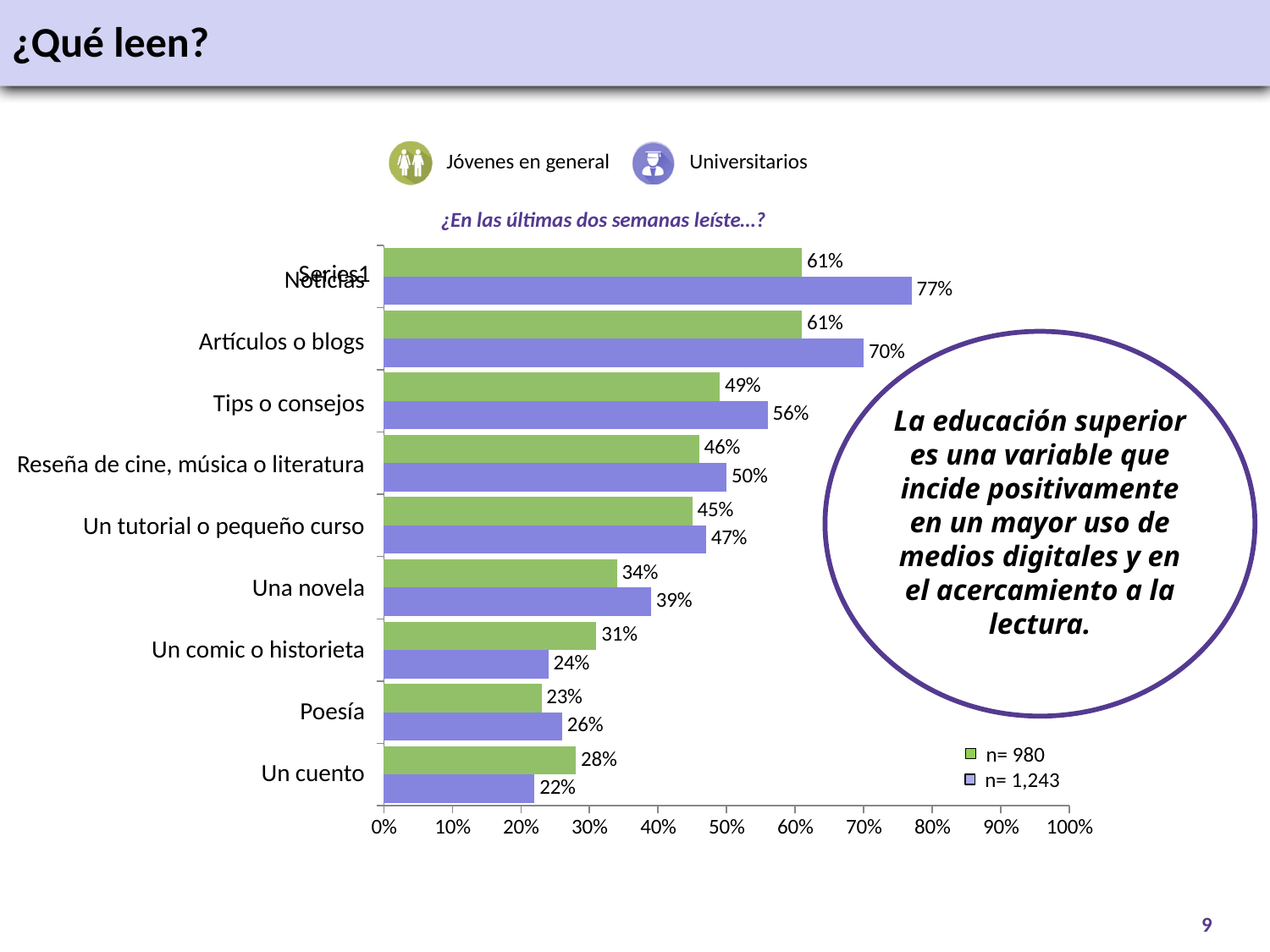
Which category has the lowest value for the green (n= 980) series? Poesía How many series does the chart legend list? 2 What is the value of the purple (n= 1,243) bar for Una novela? 39% Which category has the highest value for the purple (n= 1,243) series? Noticias What is the value of the purple (n= 1,243) bar for Noticias? 77% What is the value of the green (n= 980) bar for Tips o consejos? 49% What is the difference between the purple and green bars for Noticias? 16% Is the green (n= 980) value for Artículos o blogs greater or less than 50%? greater How many reading categories are shown on the chart? 9 For Un comic o historieta, which bar is larger, the green (n= 980) or the purple (n= 1,243)? green (n= 980) What type of chart is shown on the slide? bar chart What question is shown as the chart's subtitle? ¿En las últimas dos semanas leíste...?